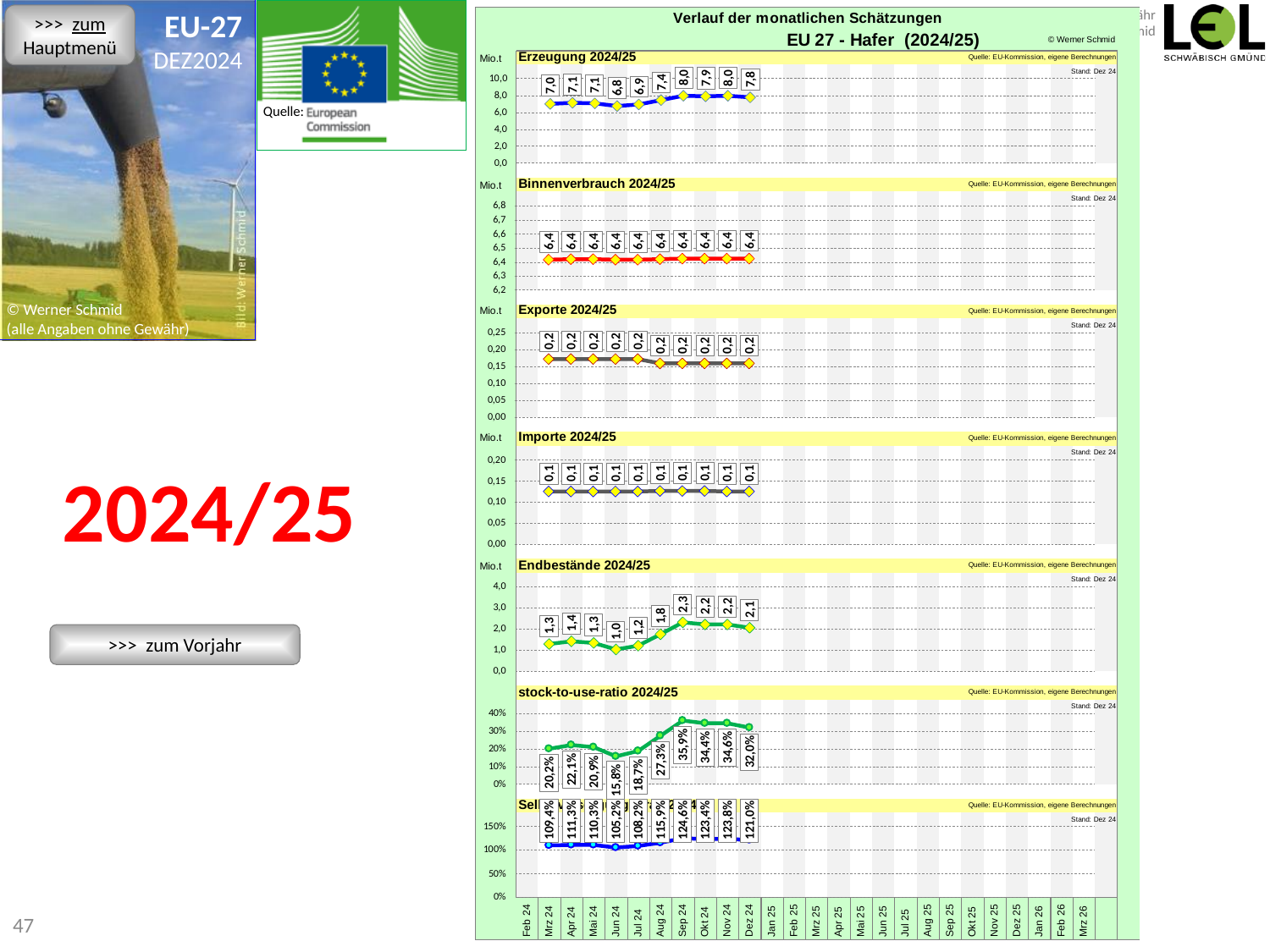
In the Binnenverbrauch 2024/25 chart, what value is shown for every month? 6,4 In the Endbestände 2024/25 chart, what is the highest value shown? 2,3 In the Importe 2024/25 chart, what is the value for Dez 24? 0,1 What kind of chart is the Endbestände 2024/25 chart? line chart In the stock-to-use-ratio 2024/25 chart, what is the value for Dez 24? 32,0% In the stock-to-use-ratio 2024/25 chart, which is larger, the value for Sep 24 or the value for Jun 24? Sep 24 In the Erzeugung 2024/25 chart, what is the value for Dez 24? 7,8 In the Erzeugung 2024/25 chart, what is the lowest value shown? 6,8 In the Erzeugung 2024/25 chart, what is the difference between the Sep 24 value (8,0) and the Jun 24 value (6,8)? 1,2 How many data points are plotted in the Erzeugung 2024/25 chart? 10 In the Exporte 2024/25 chart, what is the value for Mrz 24? 0,2 In the Endbestände 2024/25 chart, what is the value for Jun 24? 1,0